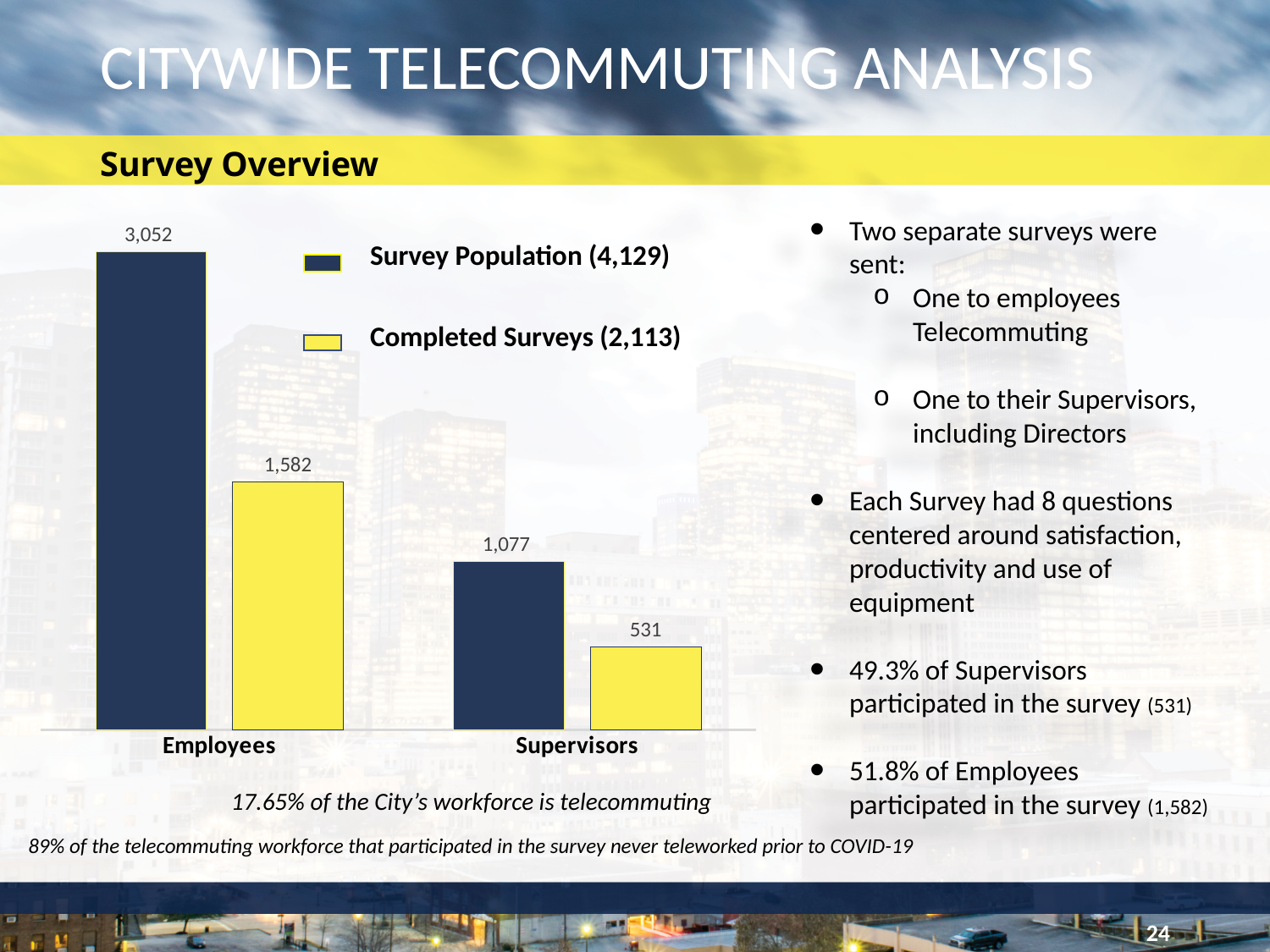
How many series does the legend list? 2 How many categories are shown on the x axis? 2 Which is larger: Completed Surveys for Employees or Survey Population for Supervisors? Completed Surveys for Employees What is the Survey Population value for Supervisors? 1,077 What kind of chart is shown on the slide? Bar chart What is the Completed Surveys value for Employees? 1,582 What is the difference between the Survey Population for Employees and for Supervisors? 1,975 Which category has the highest Survey Population? Employees What is the Completed Surveys value for Supervisors? 531 What is the difference between the Survey Population and Completed Surveys for Employees? 1,470 What is the Survey Population value for Employees? 3,052 Which category has the lowest Completed Surveys value? Supervisors